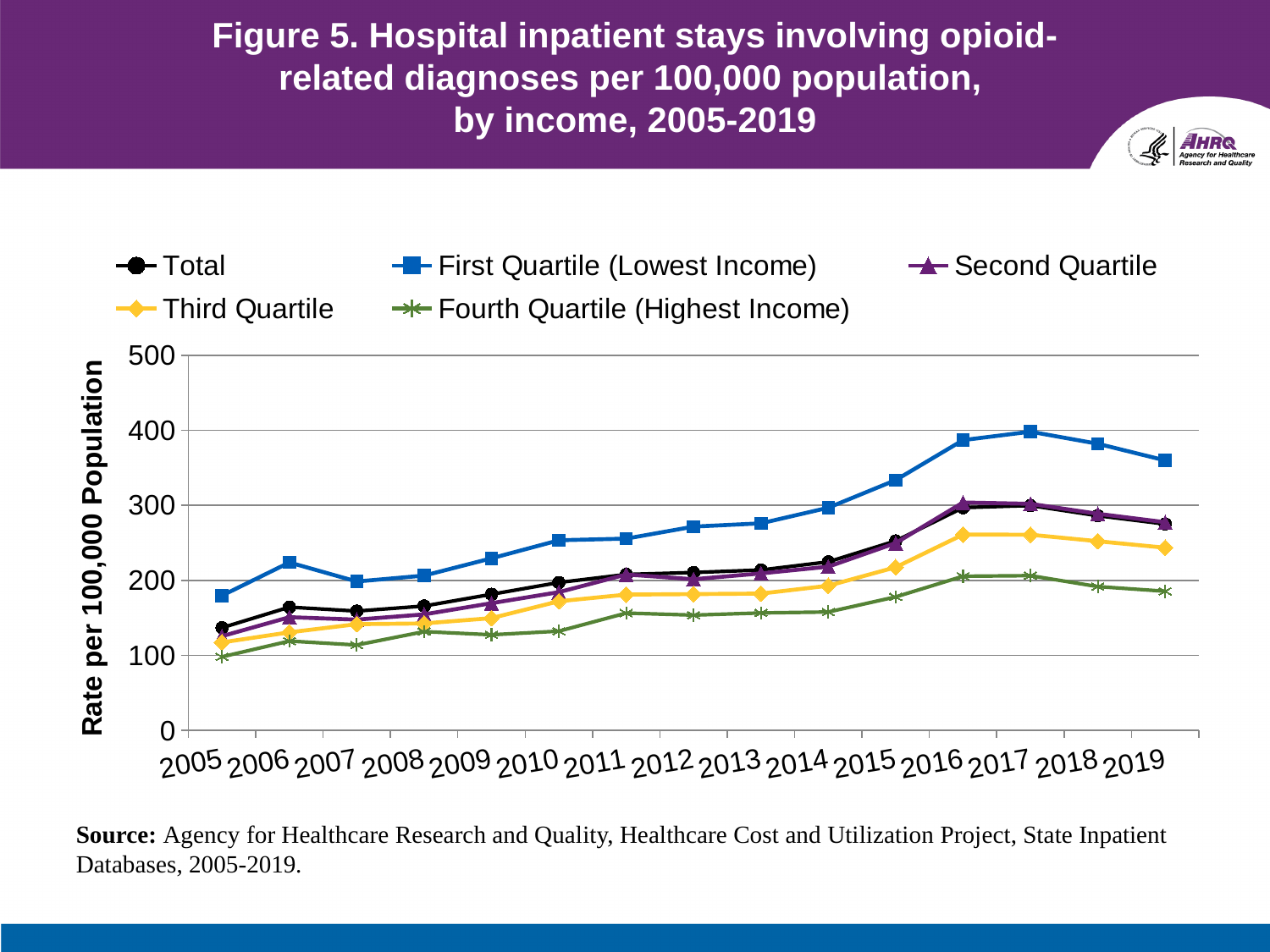
How many series does the legend list? 5 How many years are plotted along the x axis? 15 Is the value for Total in 2005 greater or less than 200? less Is the value for First Quartile (Lowest Income) in 2017 greater or less than 300? greater In 2019, which is larger: the value for First Quartile (Lowest Income) or the value for Third Quartile? First Quartile (Lowest Income) Does the First Quartile (Lowest Income) series rise or fall from 2017 to 2019? Fall Which series has the lowest value in 2019? Fourth Quartile (Highest Income) What kind of chart is shown on the slide? Line chart Is the value for Third Quartile in 2016 greater or less than 200? greater What is the label on the y axis? Rate per 100,000 Population In which year does the First Quartile (Lowest Income) series reach its highest value? 2017 Which series has the highest value in 2017? First Quartile (Lowest Income)